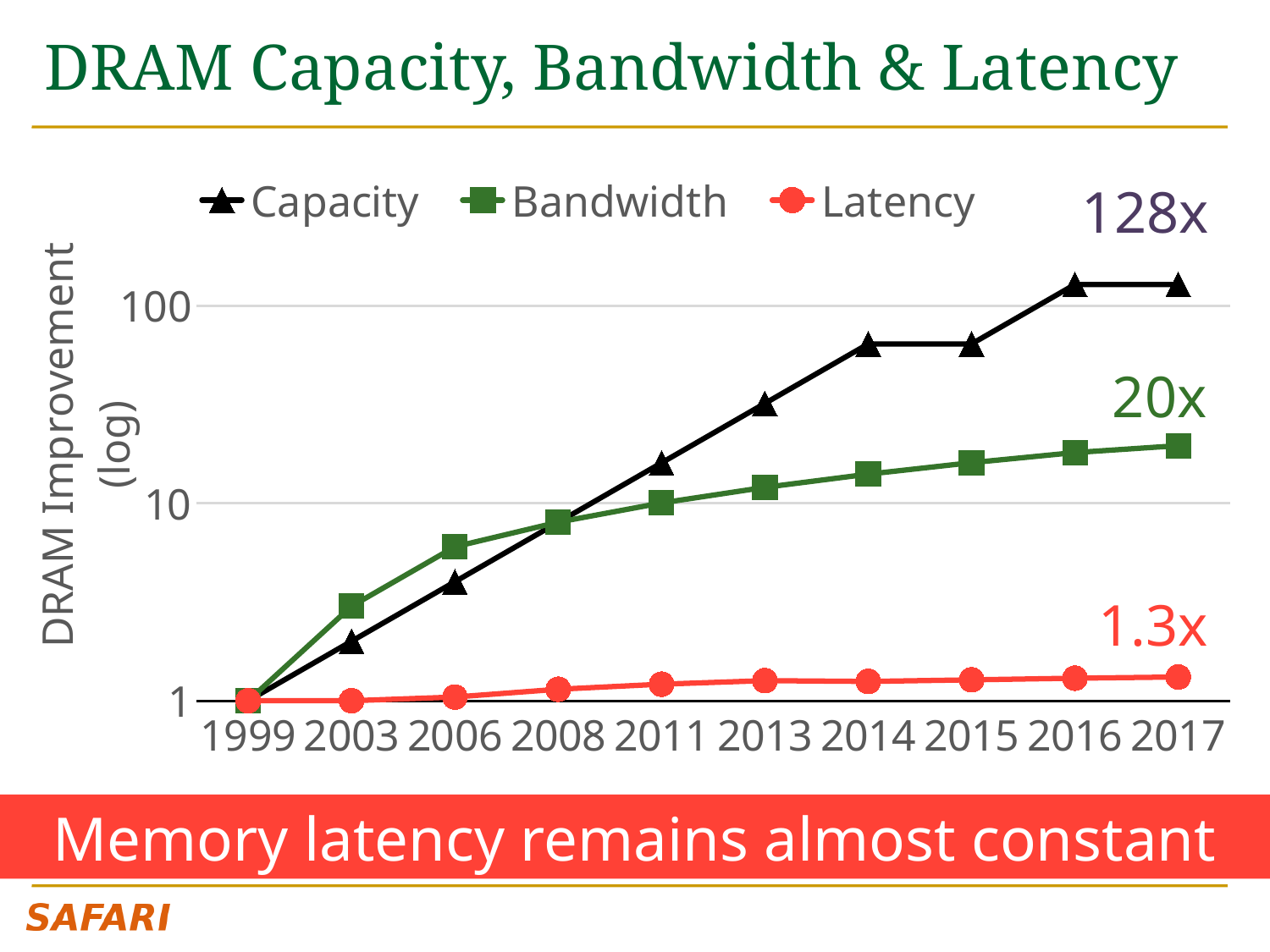
Which series has the lowest value in 2017? Latency In 2006, which is larger: Capacity or Bandwidth? Bandwidth What improvement factor is labelled for Bandwidth at the end of the chart? 20x What improvement factor is labelled for Capacity at the end of the chart? 128x What is the label of the y axis? DRAM Improvement (log) How many series does the legend list? 3 How many years are shown on the x axis? 10 Does the Capacity series rise or fall from 1999 to 2017? rise What improvement factor is labelled for Latency at the end of the chart? 1.3x What kind of chart is shown on the slide? line chart Is the Capacity value in 2017 greater or less than 100? greater Which series has the highest value in 2017? Capacity